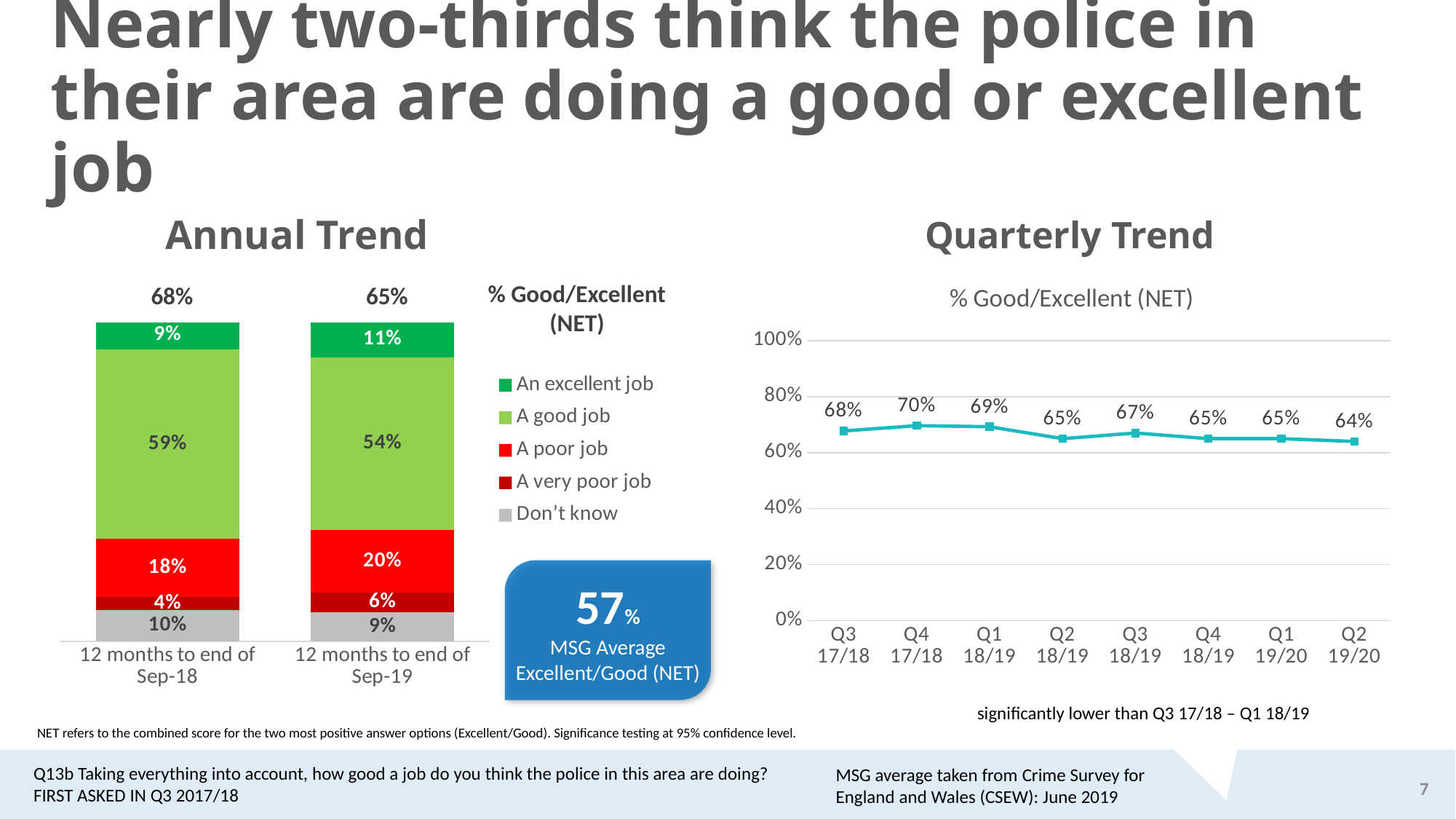
In the Annual Trend chart, what is the difference between the 'A good job' values for Sep-18 and Sep-19? 5% What kind of chart is the Annual Trend chart? Stacked bar chart In the Annual Trend chart, what is the % Good/Excellent (NET) for the 12 months to end of Sep-18? 68% In the Annual Trend chart, how many series does the legend list? 5 In the Quarterly Trend chart, what is the difference between the values for Q4 17/18 and Q2 19/20? 6% In the Quarterly Trend chart, do the values generally rise or fall from Q3 17/18 to Q2 19/20? Fall In the Annual Trend chart, which period has the larger 'A poor job' value, 12 months to end of Sep-18 or 12 months to end of Sep-19? 12 months to end of Sep-19 In the Quarterly Trend chart, what is the % Good/Excellent (NET) for Q4 17/18? 70% In the Annual Trend chart, what percentage said the police are doing a good job in the 12 months to end of Sep-19? 54% In the Quarterly Trend chart, which quarter has the lowest % Good/Excellent (NET)? Q2 19/20 In the Annual Trend chart, what percentage said 'A very poor job' in the 12 months to end of Sep-18? 4% In the Quarterly Trend chart, how many quarters are plotted? 8